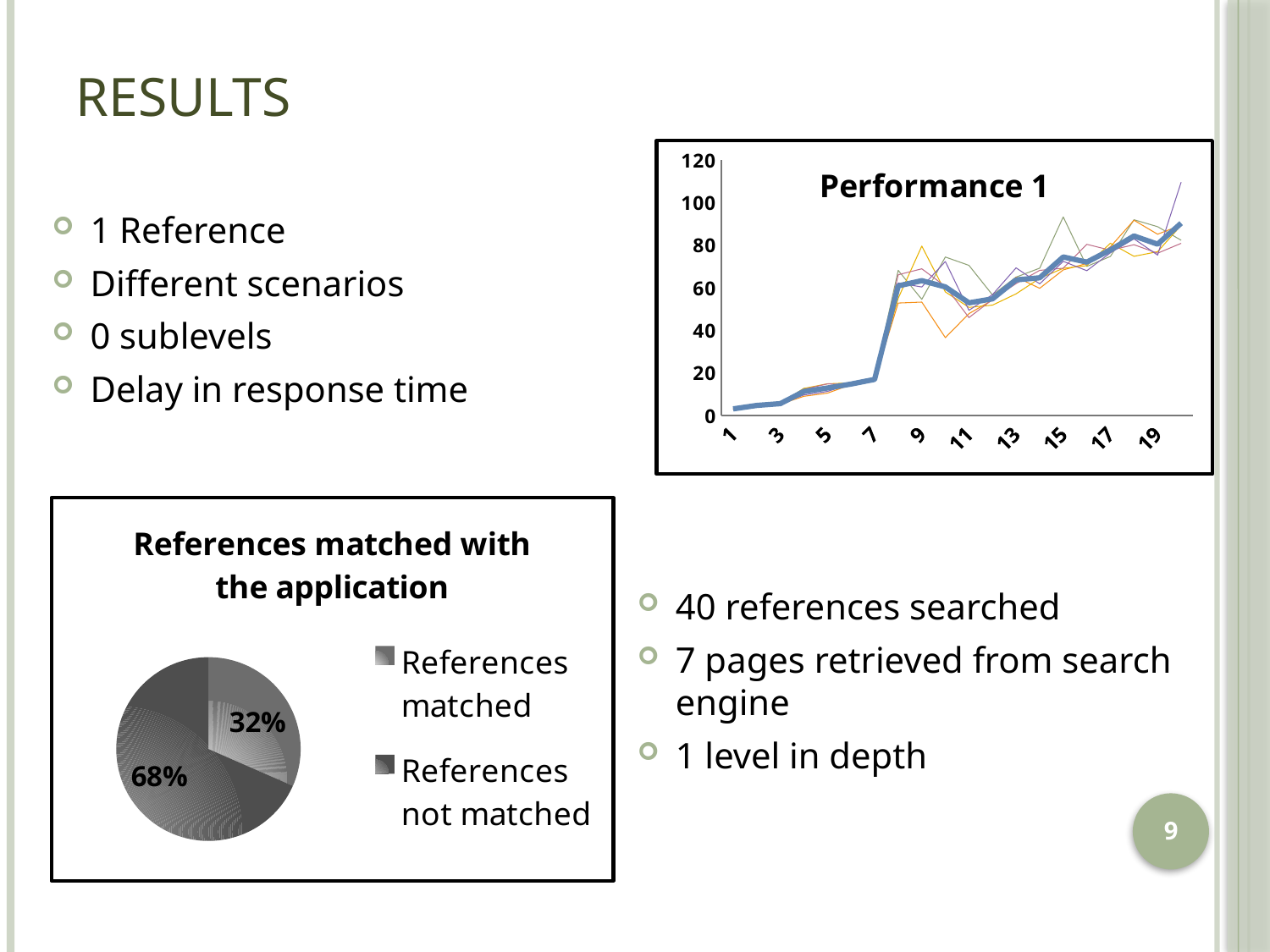
In the pie chart 'References matched with the application', what is the difference in percentage points between the two slices? 36 In the pie chart 'References matched with the application', what percentage is shown for References not matched? 68% In the pie chart 'References matched with the application', which slice is larger, References matched or References not matched? References not matched What kind of chart is the chart titled 'References matched with the application'? pie chart In the 'Performance 1' chart, is the value of the thick line at x = 9 greater or less than 40? greater In the pie chart 'References matched with the application', what percentage is shown for References matched? 32% How many entries does the legend of the pie chart 'References matched with the application' list? 2 What kind of chart is the chart titled 'Performance 1'? line chart What is the highest value labelled on the y axis of the 'Performance 1' chart? 120 In the 'Performance 1' chart, is the value of the thick line at x = 1 greater or less than 20? less How many slices does the pie chart 'References matched with the application' have? 2 In the 'Performance 1' chart, do the values generally rise or fall along the x axis? rise